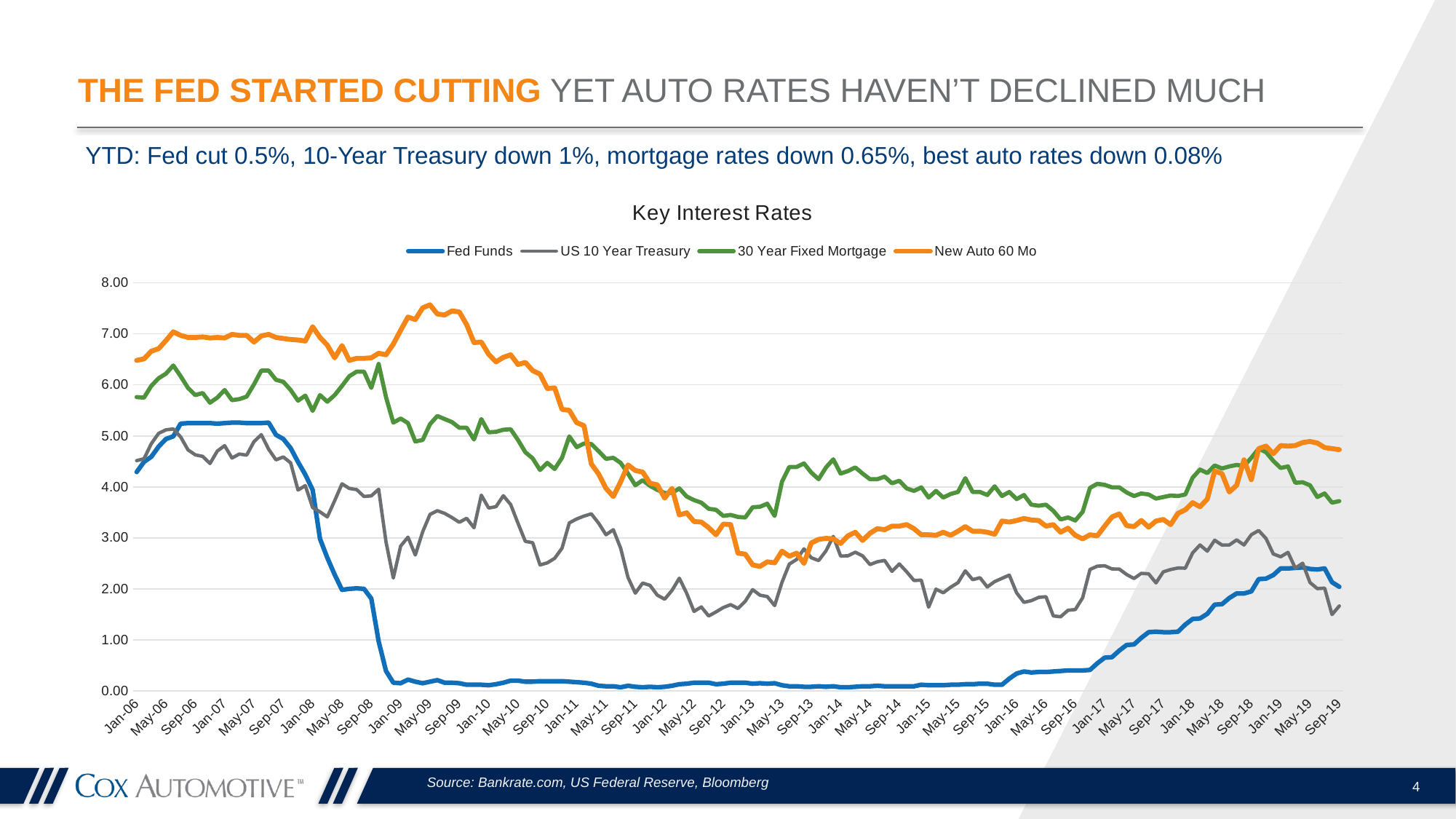
Which series has the lowest value at Jan-13? Fed Funds What is the title of the chart on the slide? Key Interest Rates Does the Fed Funds line rise or fall between Jan-16 and Jan-19? Rise Is the Fed Funds value in Jan-13 greater or less than 1.00? less How many series does the legend of the Key Interest Rates chart list? 4 What kind of chart is shown on the slide? Line chart Is the New Auto 60 Mo value in Sep-19 greater or less than 4.00? greater Which series has the highest value at Sep-19? New Auto 60 Mo Which colour is used for the Fed Funds line in the chart? Blue Is the peak New Auto 60 Mo value around May-09 greater or less than 7.00? greater At Sep-19, which is higher: New Auto 60 Mo or 30 Year Fixed Mortgage? New Auto 60 Mo